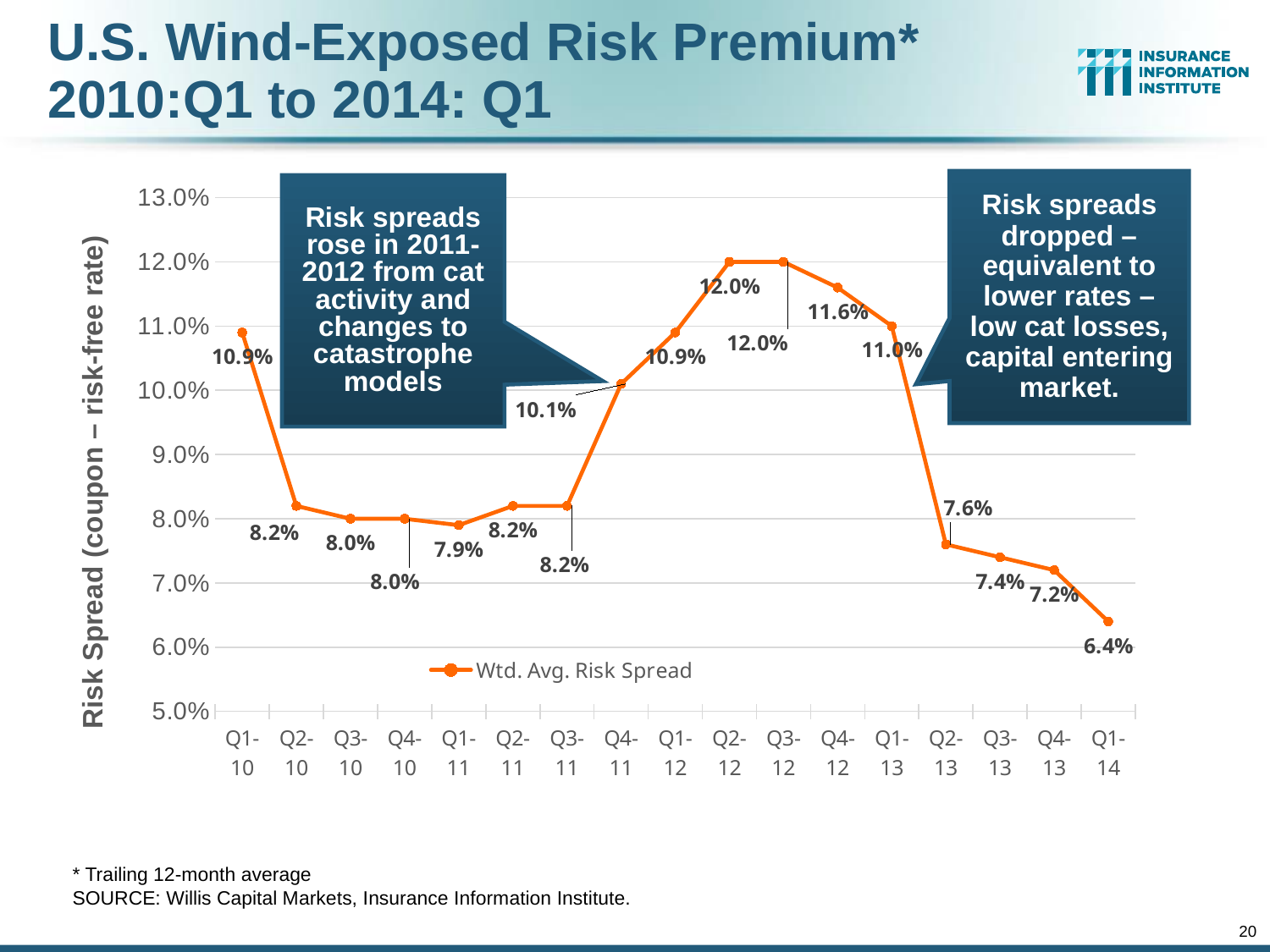
What is the weighted average risk spread for Q1-10? 10.9% Which quarter has the lowest risk spread? Q1-14 How many quarters are plotted on the x axis? 17 What is the weighted average risk spread for Q1-14? 6.4% What value is shown for Q4-11? 10.1% Which is larger, the risk spread for Q4-12 or for Q1-13? Q4-12 Does the risk spread rise or fall from Q1-13 to Q1-14? Fall What value is shown for Q1-11? 7.9% By how many percentage points did the risk spread fall from Q1-13 to Q2-13? 3.4 percentage points What is the highest risk spread value plotted on the chart? 12.0% What kind of chart is shown on the slide? Line chart How many series does the legend list? 1